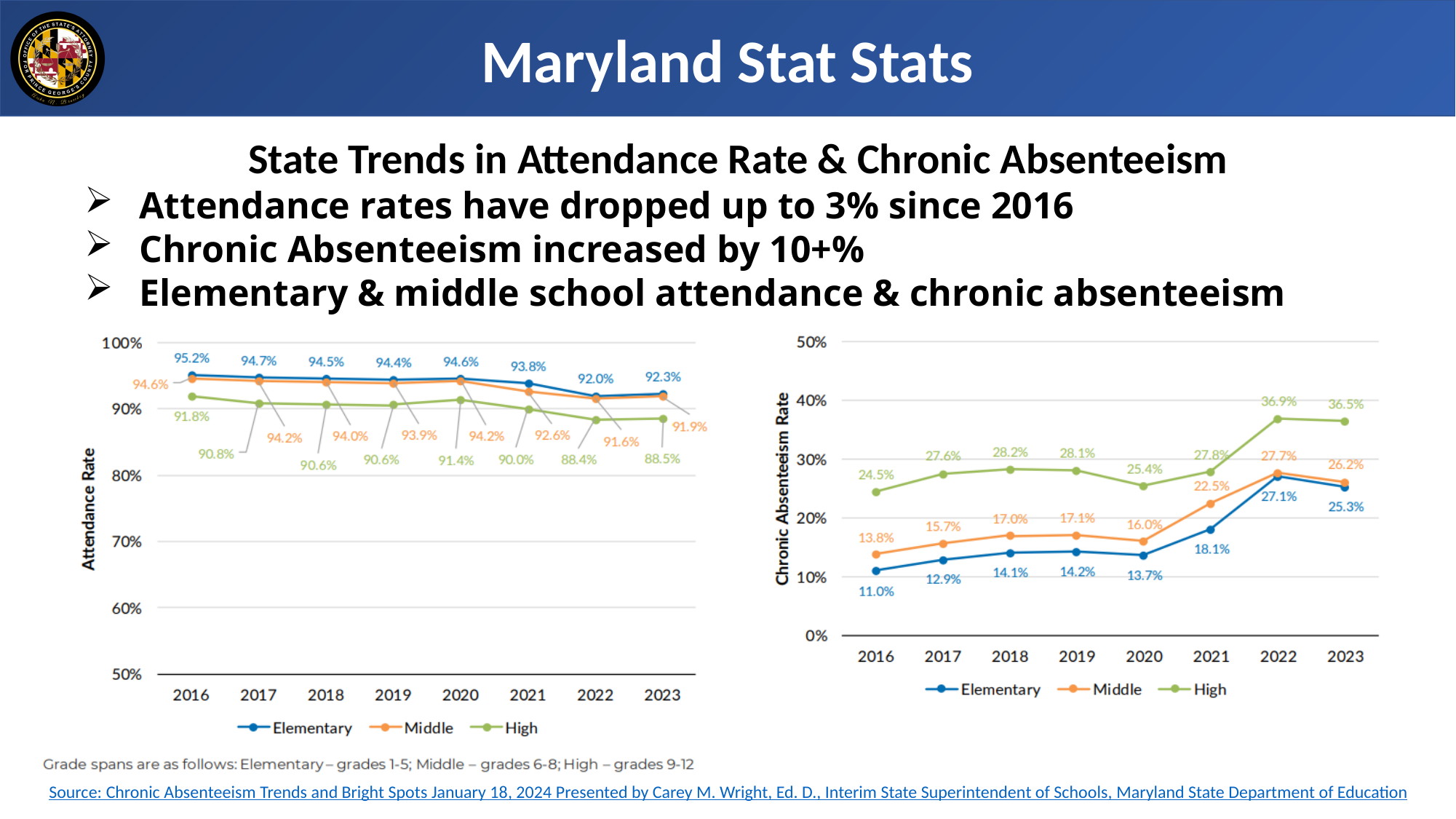
In the Chronic Absenteeism Rate chart on the right, is the High school value for 2023 greater or less than 30%? greater In the Chronic Absenteeism Rate chart on the right, does the Elementary rate generally rise or fall from 2016 to 2023? Rise In the Chronic Absenteeism Rate chart on the right, what is the difference between the Middle school rate in 2023 and in 2016? 12.4% How many series does the legend of the Attendance Rate chart on the left list? 3 What type of chart is the Chronic Absenteeism Rate chart on the right? Line chart In the Attendance Rate chart on the left, what was the Elementary attendance rate in 2016? 95.2% In the Attendance Rate chart on the left, which year had the lowest Middle school attendance rate? 2022 In the Attendance Rate chart on the left, which was higher in 2021: the Elementary rate or the High rate? Elementary In the Attendance Rate chart on the left, what was the High school attendance rate in 2022? 88.4% In the Chronic Absenteeism Rate chart on the right, which year had the highest Elementary chronic absenteeism rate? 2022 In the Chronic Absenteeism Rate chart on the right, what was the High school chronic absenteeism rate in 2022? 36.9% How many years are shown on the x axis of the Chronic Absenteeism Rate chart on the right? 8